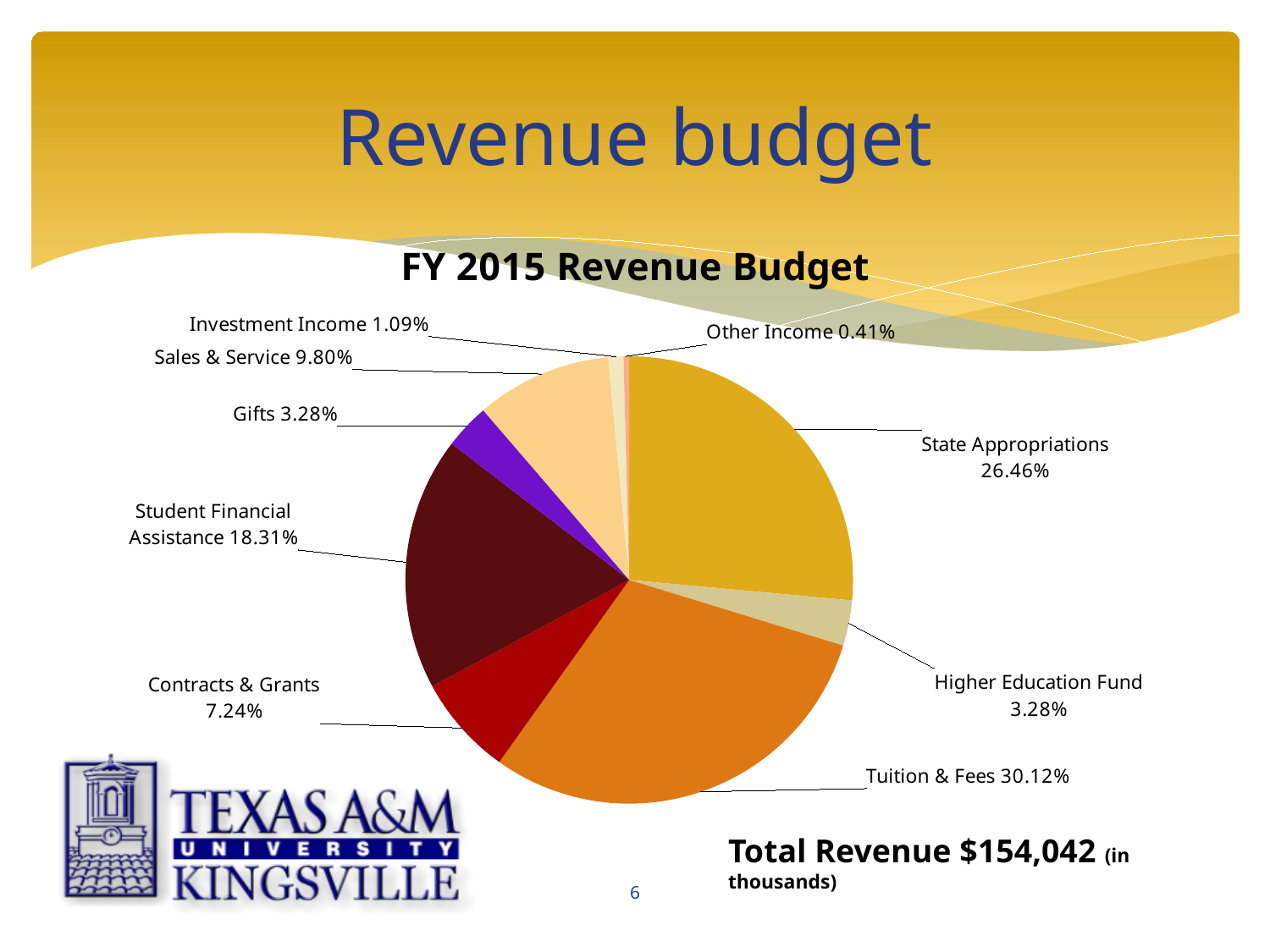
How many categories are shown in the pie chart? 9 What share of the FY 2015 revenue budget comes from State Appropriations? 26.46% What kind of chart is shown on the slide? Pie chart What percentage is shown for Sales & Service? 9.80% What percentage is shown for Student Financial Assistance? 18.31% Which category has the largest share of the FY 2015 revenue budget? Tuition & Fees What share of the FY 2015 revenue budget comes from Tuition & Fees? 30.12% Which is larger, Contracts & Grants or Sales & Service? Sales & Service Which category has the smallest share of the FY 2015 revenue budget? Other Income What is the title of the chart? FY 2015 Revenue Budget What is the difference in percentage points between Tuition & Fees and State Appropriations? 3.66 What total revenue is stated below the chart? $154,042 (in thousands)